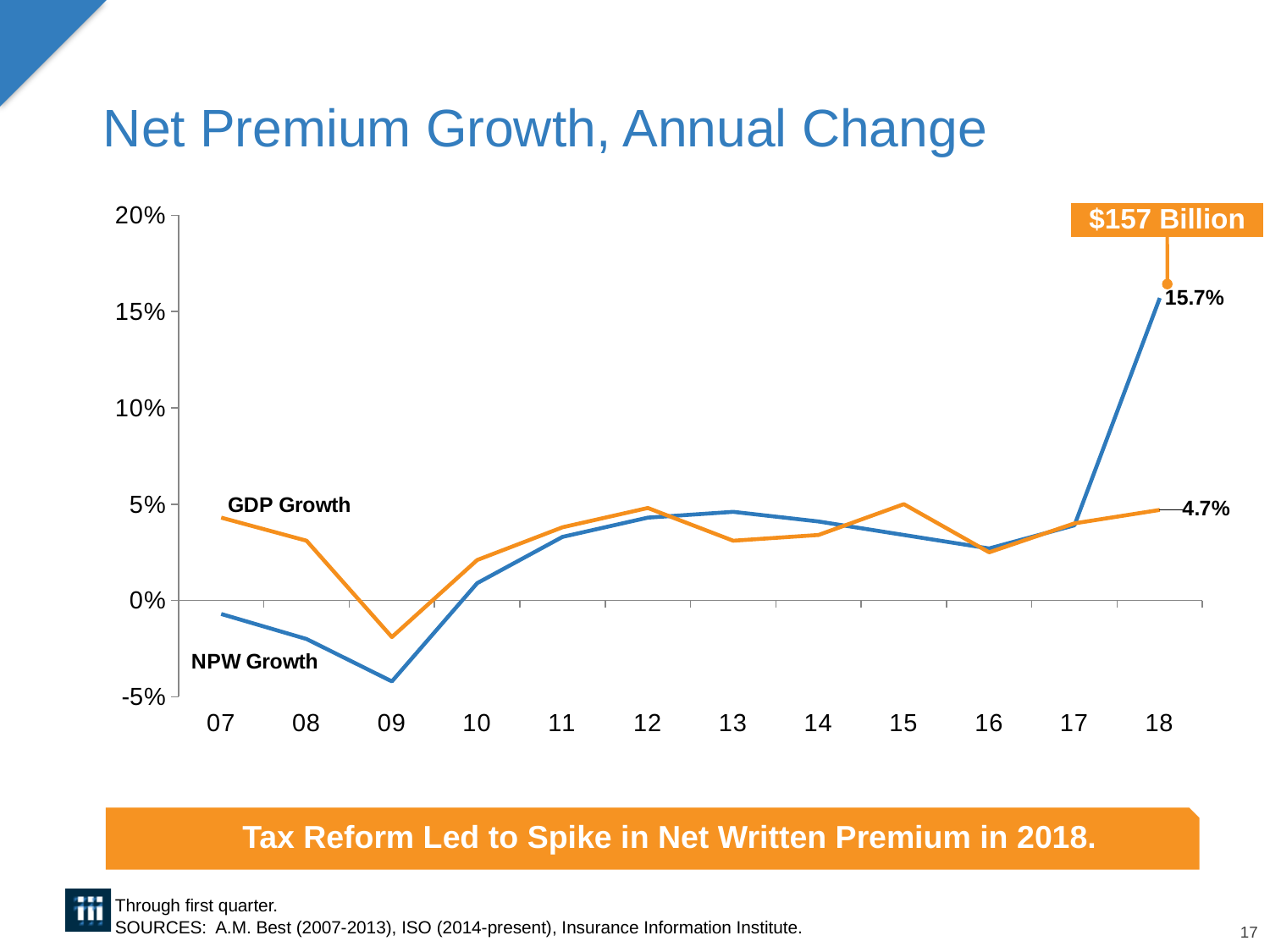
What kind of chart is shown on the slide? line chart In which year is NPW Growth highest? 18 How many series are plotted on the chart? 2 What is the GDP Growth value for 18? 4.7% Is the NPW Growth value for 09 greater or less than 0%? less What dollar amount is shown in the callout above the 18 data point? $157 Billion In 18, which series is higher, NPW Growth or GDP Growth? NPW Growth What is the NPW Growth value for 18? 15.7% In 07, which series is higher, GDP Growth or NPW Growth? GDP Growth What is the difference between NPW Growth and GDP Growth in 18? 11.0 percentage points In which year is NPW Growth lowest? 09 How many years are shown on the x axis? 12